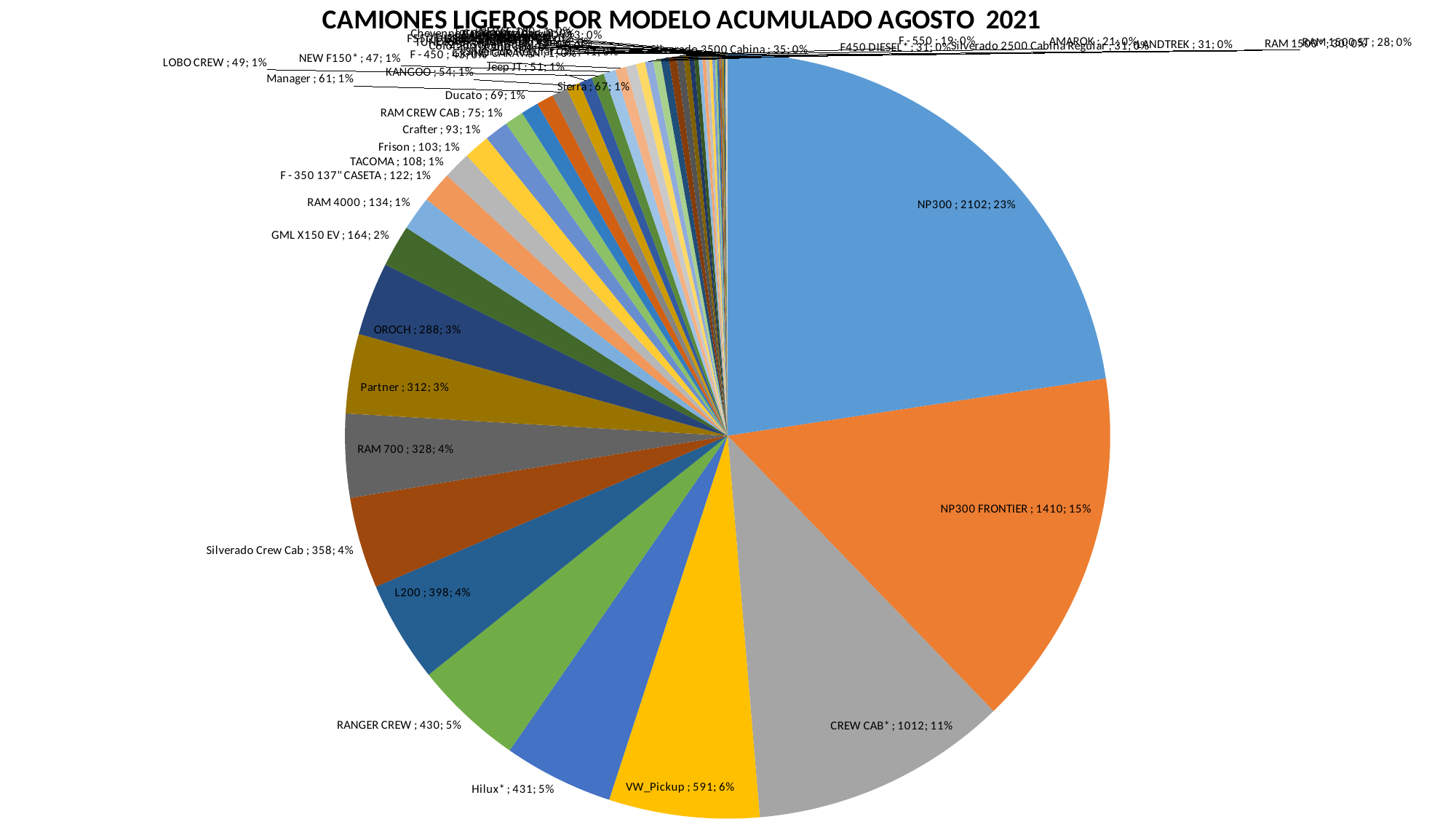
What is the value shown for NP300 FRONTIER? 1410 What is the title of the chart? CAMIONES LIGEROS POR MODELO ACUMULADO AGOSTO 2021 What is the value shown for OROCH? 288 Which model has the largest slice of the pie? NP300 What is the value shown for RAM 700? 328 What is the value shown for VW_Pickup? 591 What is the difference between the values for NP300 and NP300 FRONTIER? 692 What is the difference between the values for Hilux* and RANGER CREW? 1 Which is larger, the value for L200 or the value for Silverado Crew Cab? L200 What share of the pie does NP300 represent? 23% What share of the pie does CREW CAB* represent? 11% What kind of chart is shown on the slide? pie chart